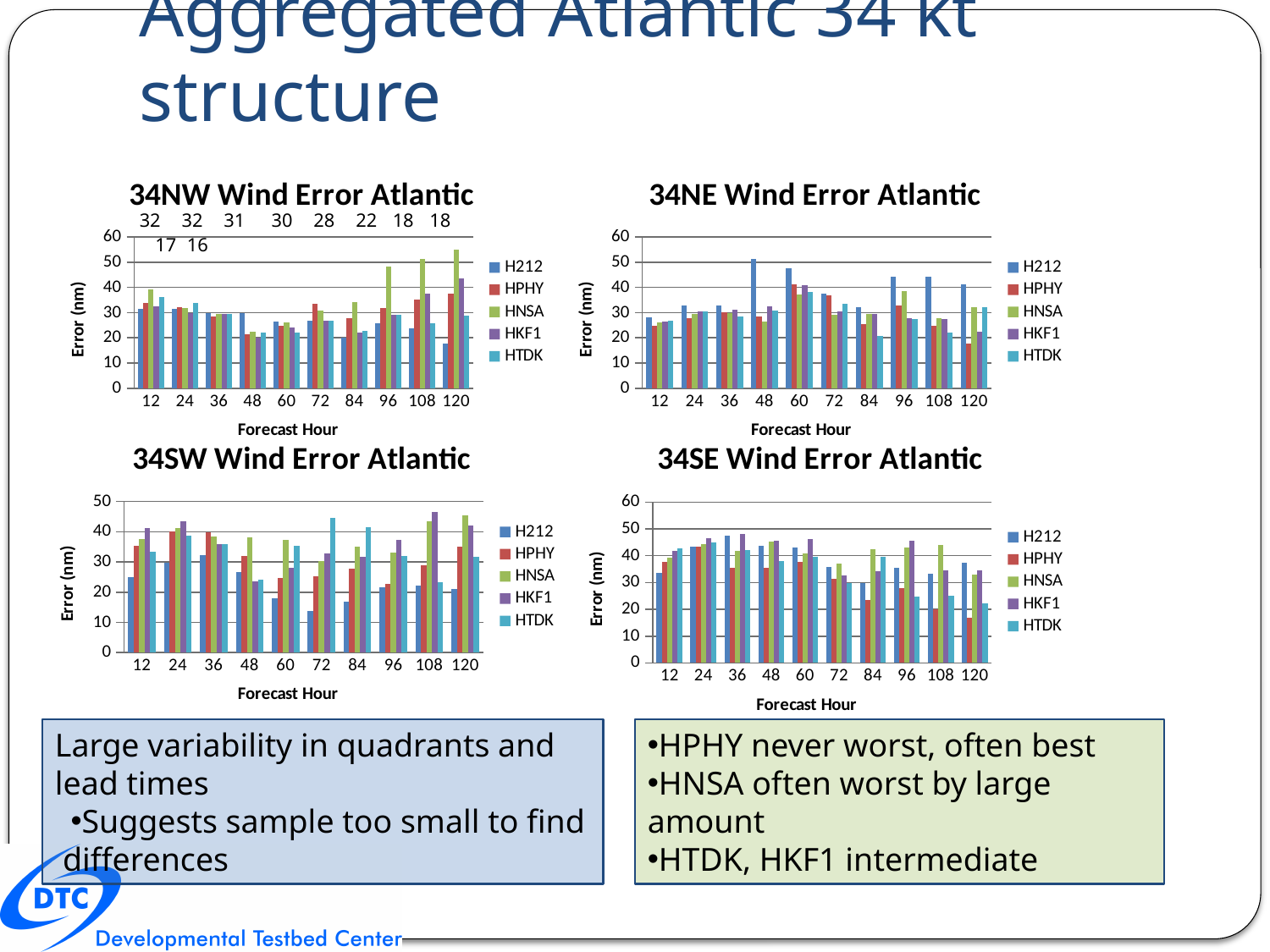
In the 34NE Wind Error Atlantic chart, which series has the lowest bar at forecast hour 120? HPHY In the 34NW Wind Error Atlantic chart, is the value for HNSA at forecast hour 120 greater or less than 40? greater In the 34SE Wind Error Atlantic chart, is the value for HKF1 at forecast hour 36 greater or less than 40? greater In the 34NE Wind Error Atlantic chart, is the value for H212 at forecast hour 48 greater or less than 40? greater What kind of chart is the 34NW Wind Error Atlantic chart? bar chart In the 34NW Wind Error Atlantic chart, which series has the highest bar at forecast hour 96? HNSA How many series does the legend of the 34NE Wind Error Atlantic chart list? 5 In the 34NE Wind Error Atlantic chart, at forecast hour 48, which is larger: H212 or HPHY? H212 How many forecast hour categories are shown on the x axis of the 34SW Wind Error Atlantic chart? 10 What is the y-axis title of the 34SW Wind Error Atlantic chart? Error (nm)